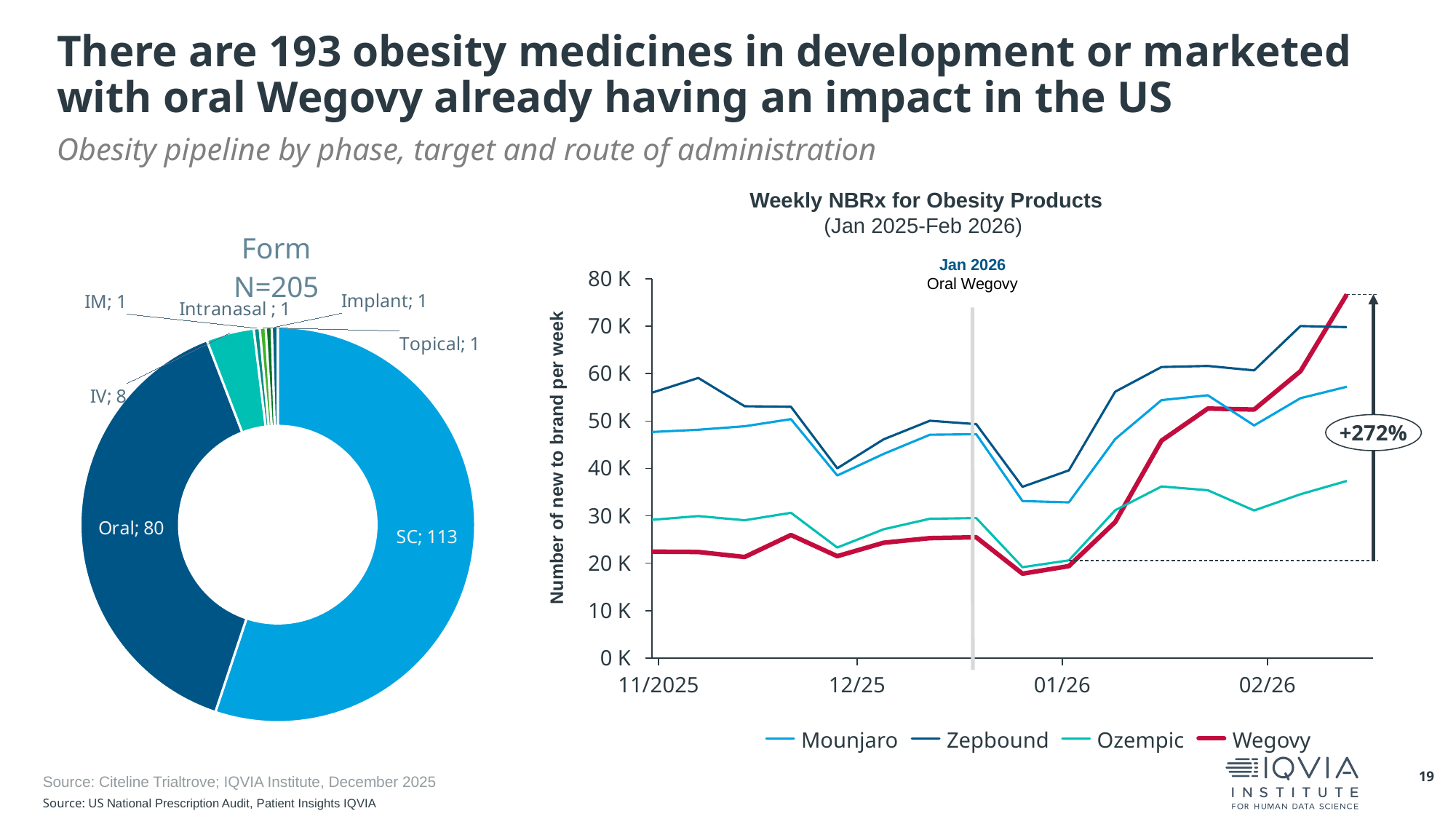
In the Weekly NBRx for Obesity Products chart, what percentage increase is annotated for Wegovy? +272% In the Weekly NBRx for Obesity Products chart, which series has the lowest value at 11/2025? Wegovy In the Form donut chart, which form has the largest slice? SC In the Form donut chart, what is the value for Oral? 80 How many form categories are shown in the Form donut chart? 7 In the Form donut chart, what is the difference between the SC and Oral values? 33 In the Form donut chart, what is the value for SC? 113 In the Form donut chart, what is the value for IV? 8 How many series does the legend of the Weekly NBRx for Obesity Products chart list? 4 What is the N value shown for the Form donut chart? N=205 What kind of chart is the Weekly NBRx for Obesity Products chart? Line chart In the Weekly NBRx for Obesity Products chart, is the Zepbound value at 11/2025 greater or less than 50 K? greater